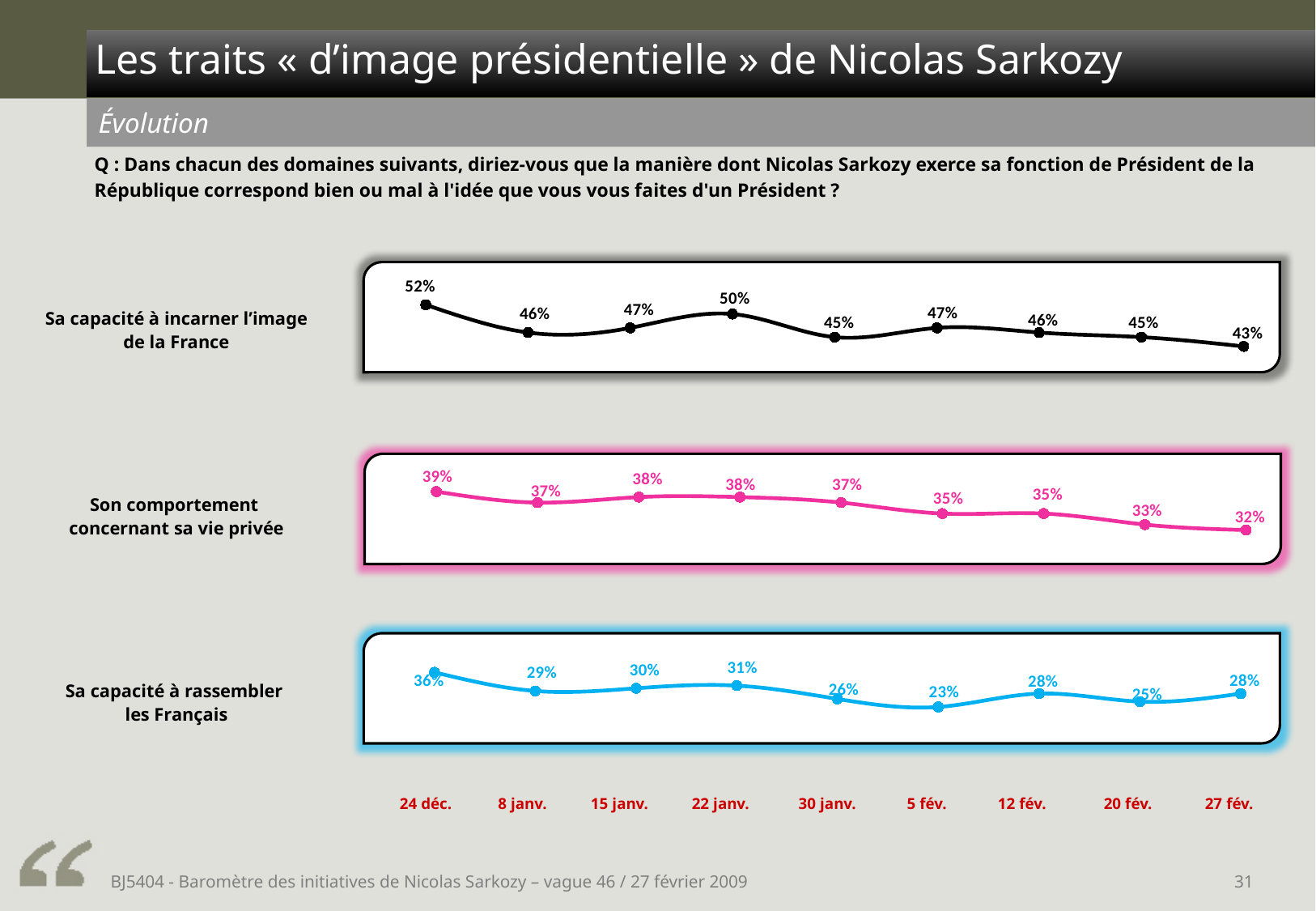
How many dates are plotted in each chart on the slide? 9 In the chart 'Sa capacité à rassembler les Français', which is larger, the value on 22 janv. or the value on 30 janv.? 22 janv. In the chart 'Sa capacité à incarner l'image de la France', what is the value on 24 déc.? 52% In the chart 'Sa capacité à incarner l'image de la France', what is the difference between the values on 24 déc. and 27 fév.? 9 percentage points In the chart 'Sa capacité à incarner l'image de la France', on which date is the value highest? 24 déc. In the chart 'Sa capacité à rassembler les Français', what is the value on 5 fév.? 23% In the chart 'Son comportement concernant sa vie privée', do the values generally rise or fall from 24 déc. to 27 fév.? fall In the chart 'Sa capacité à incarner l'image de la France', what is the value on 27 fév.? 43% In the chart 'Son comportement concernant sa vie privée', on which date is the value lowest? 27 fév. What type of chart is used for 'Sa capacité à rassembler les Français'? line chart In the chart 'Sa capacité à rassembler les Français', on which date is the value lowest? 5 fév. In the chart 'Son comportement concernant sa vie privée', what is the value on 5 fév.? 35%